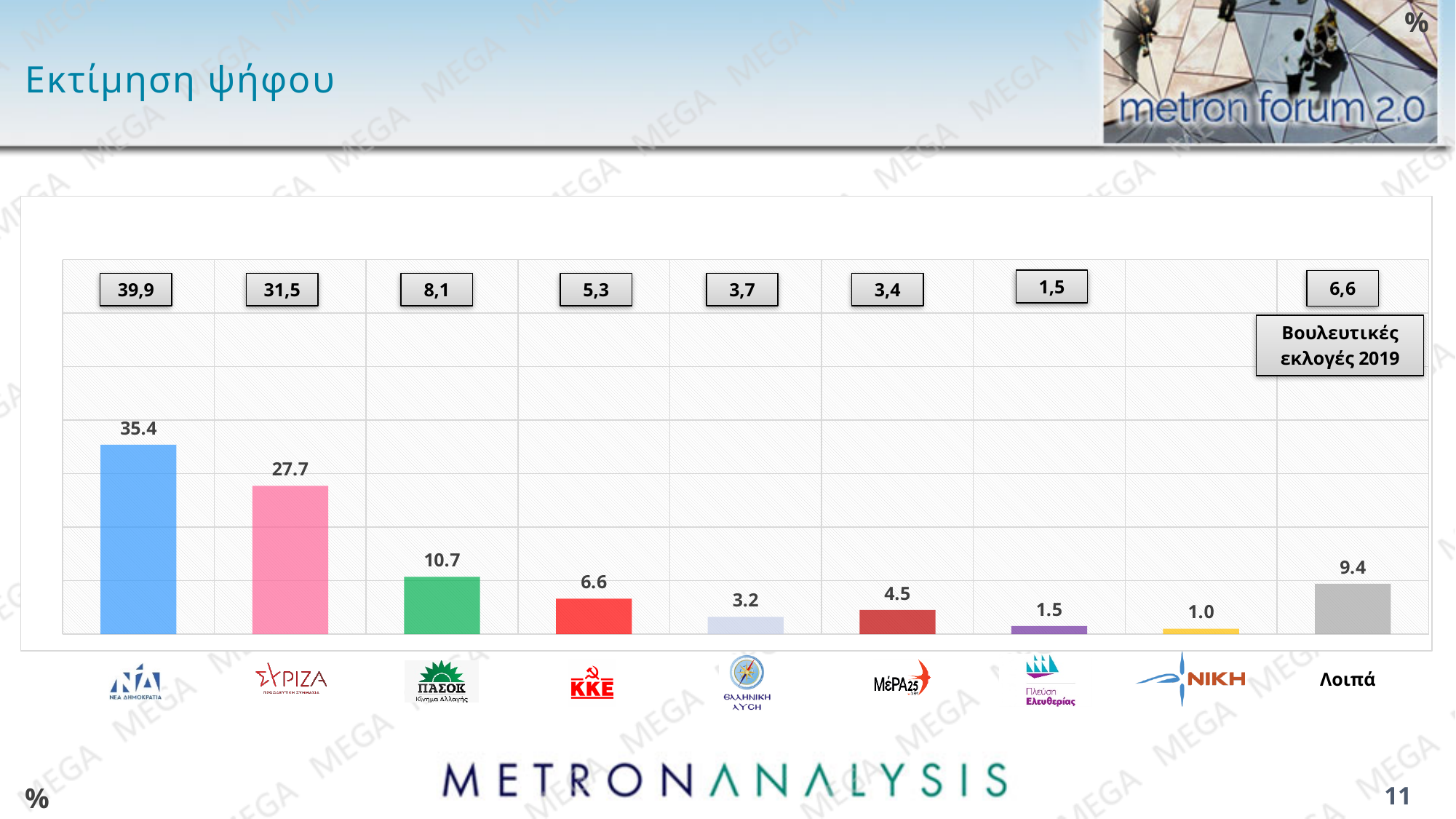
What is the vote estimate shown for ΝΕΑ ΔΗΜΟΚΡΑΤΙΑ? 35.4 What value is shown for Λοιπά? 9.4 Which party has the highest vote estimate? ΝΕΑ ΔΗΜΟΚΡΑΤΙΑ What is the vote estimate shown for ΣΥΡΙΖΑ? 27.7 What is the 2019 parliamentary election (Βουλευτικές εκλογές 2019) value shown in the box above the ΝΕΑ ΔΗΜΟΚΡΑΤΙΑ bar? 39,9 Which is larger, the value for ΜέΡΑ25 or the value for ΕΛΛΗΝΙΚΗ ΛΥΣΗ? ΜέΡΑ25 What kind of chart is shown on the slide? Bar chart How many bars are plotted in the chart? 9 Which category has the lowest bar? ΝΙΚΗ What value is shown for ΠΑΣΟΚ? 10.7 What value is shown for ΚΚΕ? 6.6 What is the difference between the values for ΝΕΑ ΔΗΜΟΚΡΑΤΙΑ and ΣΥΡΙΖΑ? 7.7